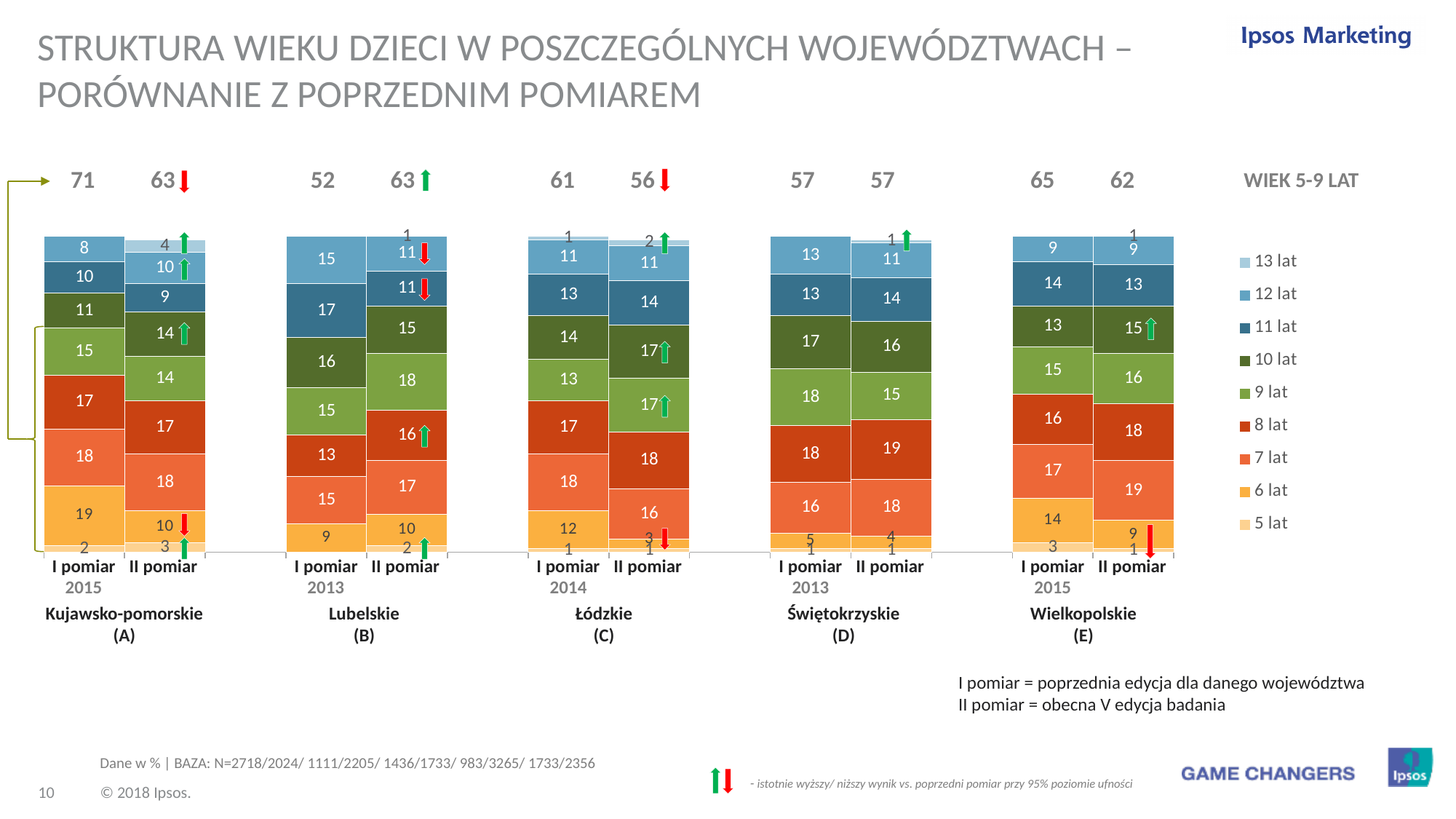
Which voivodeship has the highest WIEK 5-9 LAT value in I pomiar? Kujawsko-pomorskie (A) What is the WIEK 5-9 LAT value shown above the II pomiar bar for Łódzkie (C)? 56 Which is larger for Wielkopolskie (E): the 7 lat value in I pomiar or in II pomiar? II pomiar What is the value for 8 lat in II pomiar for Świętokrzyskie (D)? 19 Which year is given for I pomiar in Łódzkie (C)? 2014 What is the value for 6 lat in I pomiar for Kujawsko-pomorskie (A)? 19 How many age series does the legend list? 9 What kind of chart is shown on the slide? stacked bar chart What is the value for 9 lat in II pomiar for Lubelskie (B)? 18 What is the difference between the 6 lat values in I pomiar and II pomiar for Łódzkie (C)? 9 How many voivodeships are compared on the chart? 5 What is the difference between the WIEK 5-9 LAT values for I pomiar and II pomiar in Kujawsko-pomorskie (A)? 8